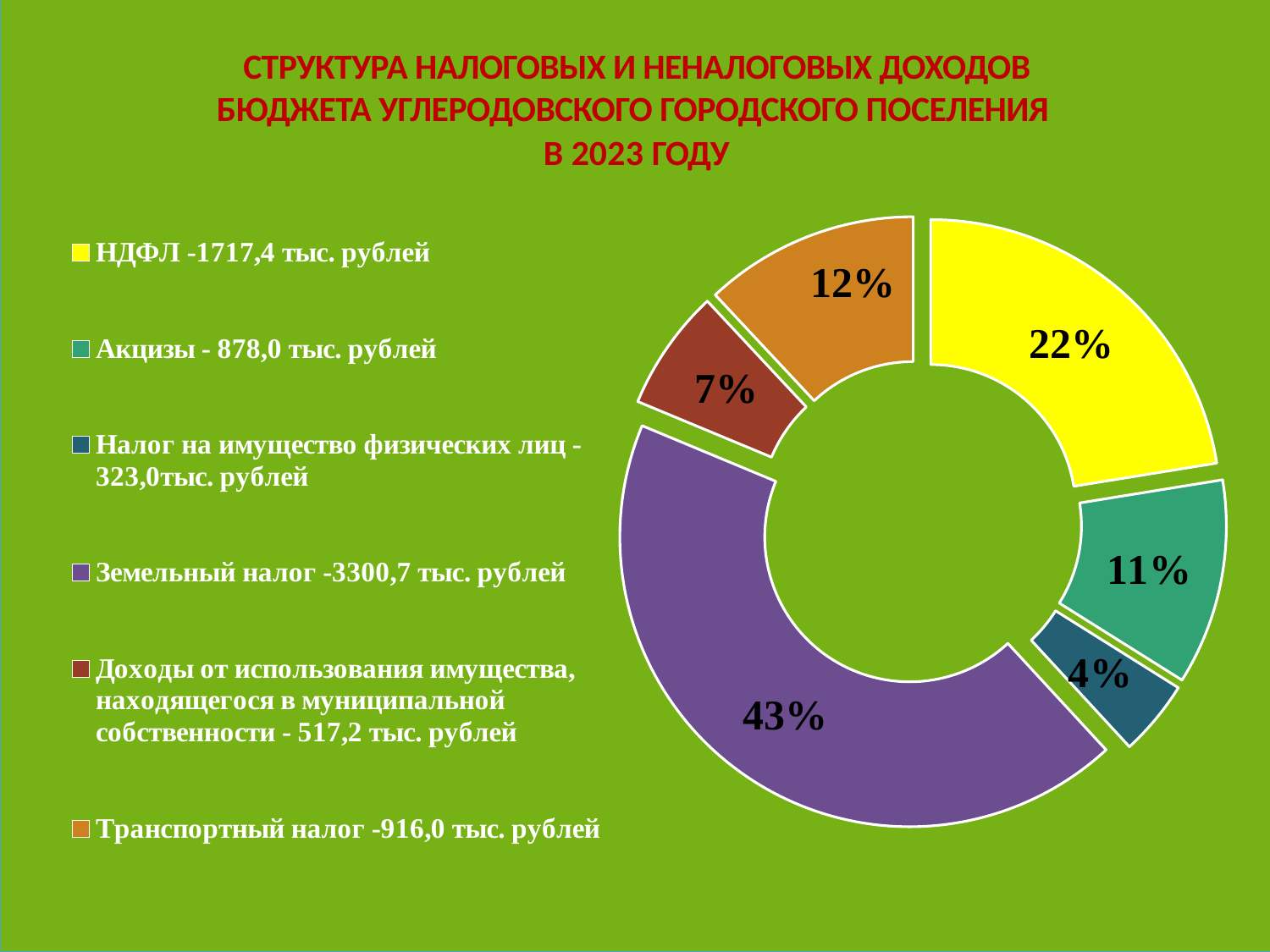
What share of the chart does Транспортный налог have? 12% What share of the chart does Налог на имущество физических лиц have? 4% What share of the chart does Земельный налог have? 43% Which is larger, the share for Транспортный налог or the share for Акцизы? Транспортный налог Which category has the largest share of the chart? Земельный налог How many categories does the chart show? 6 What kind of chart is shown on the slide? Doughnut (pie) chart Which category has the smallest share of the chart? Налог на имущество физических лиц What is the difference in percentage points between the share for Земельный налог and the share for НДФЛ? 21 According to the legend, what is the amount for Земельный налог? 3300,7 тыс. рублей